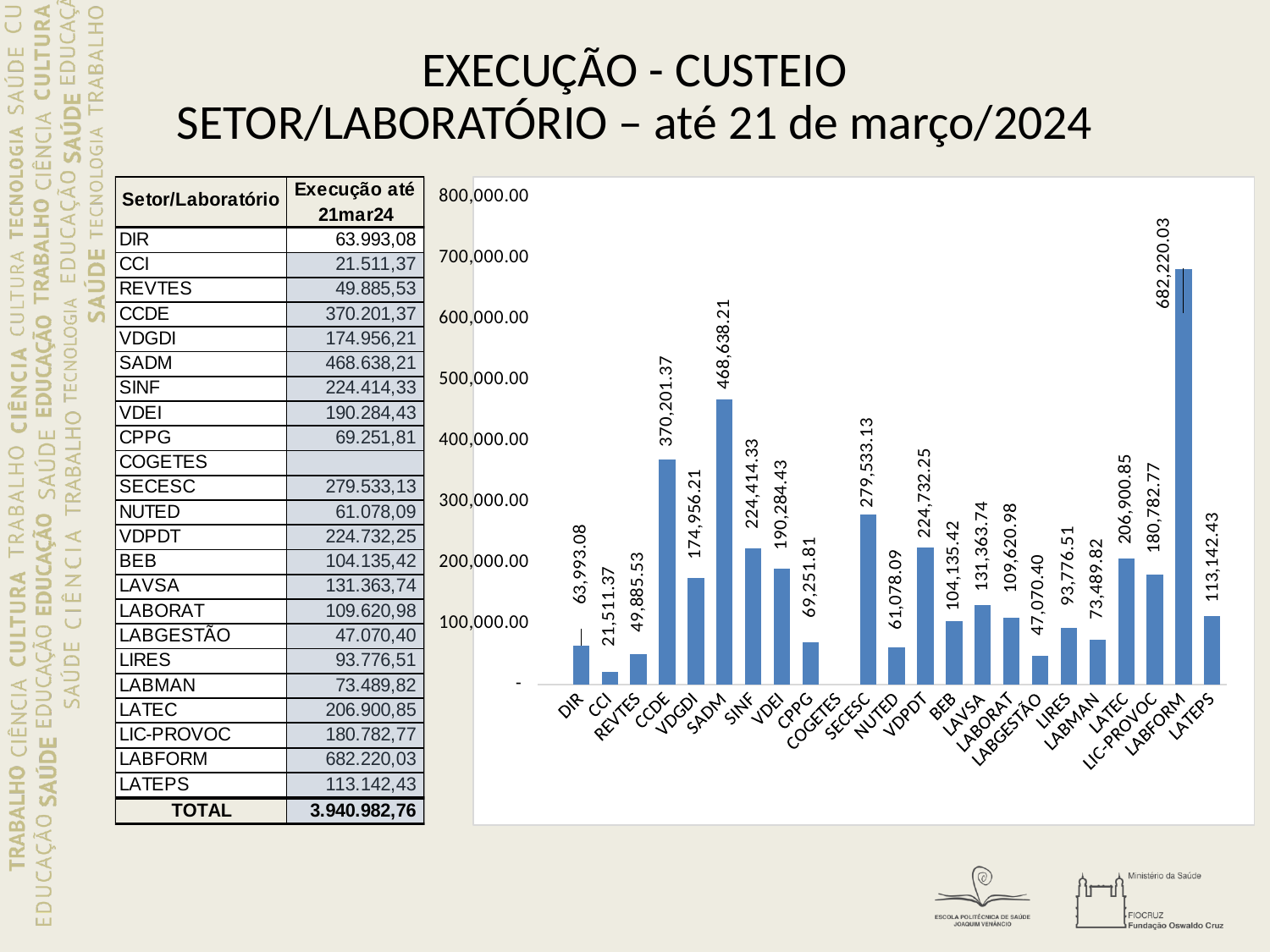
What is the difference between the values for LABFORM and SADM? 213,581.82 What is the value shown for SADM in the chart? 468,638.21 Is the value for LABFORM greater or less than 600,000.00? greater Which has a larger value, LATEC or LIC-PROVOC? LATEC Which category has the highest value in the chart? LABFORM What is the value shown for LABGESTÃO in the chart? 47,070.40 Among the categories that have a bar, which has the lowest value? CCI What is the value shown for CCDE in the chart? 370,201.37 What is the value shown for LABFORM in the chart? 682,220.03 How many categories are shown on the x axis of the chart? 23 What kind of chart is shown on the slide? bar chart What is the difference between the values for SADM and CCDE? 98,436.84